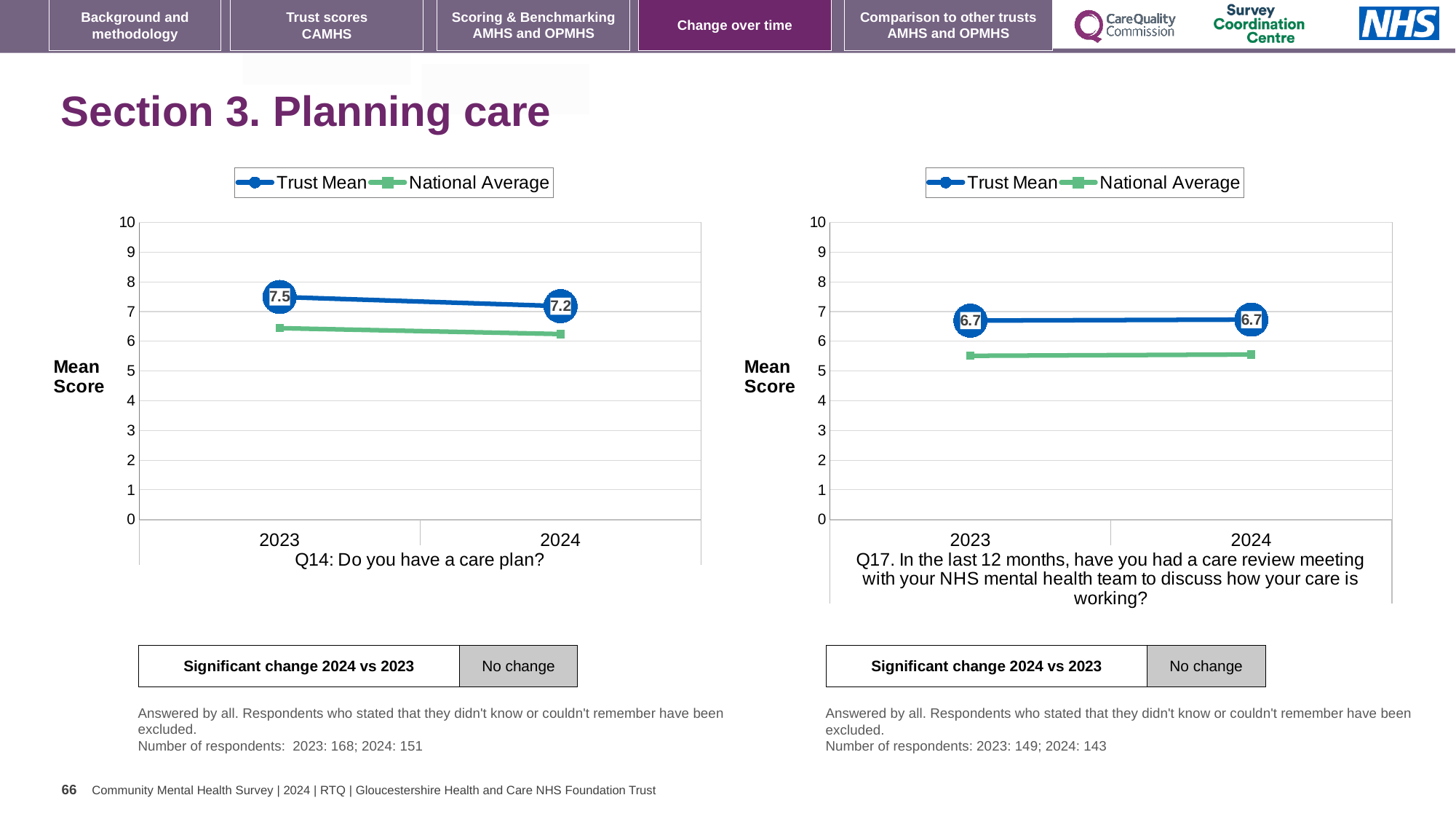
How many series does the legend of the Q17 chart (right) list? 2 In the Q17 chart (right), what is the Trust Mean score for 2024? 6.7 In the Q14 chart (left), does the Trust Mean rise or fall from 2023 to 2024? fall In the Q17 chart (right), is the National Average value for 2023 greater or less than 6? less What is the label of the y axis on the Q17 chart (right)? Mean Score In the Q17 chart (right), does the Trust Mean rise, fall or stay the same from 2023 to 2024? stay the same In the Q14 chart (left), what is the Trust Mean score for 2024? 7.2 What kind of chart is the Q14 chart on the left? line chart In the Q14 chart (left), which series has the higher value in 2024, Trust Mean or National Average? Trust Mean In the Q14 chart (left), by how much did the Trust Mean change from 2023 to 2024? 0.3 In the Q14 chart (left), what is the Trust Mean score for 2023? 7.5 How many years are plotted on the x axis of the Q14 chart (left)? 2